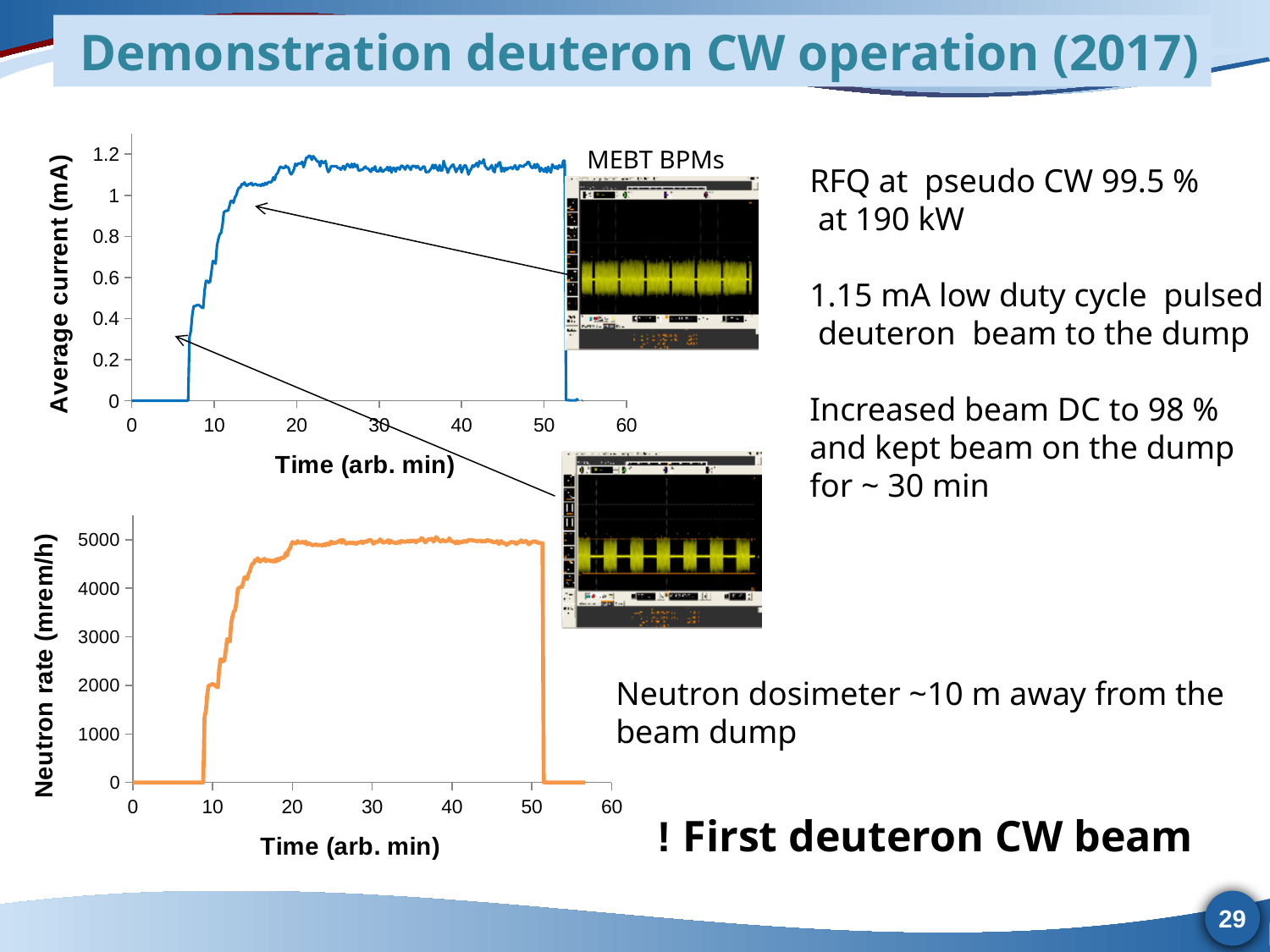
In the top chart, is the average current at time 10 greater or less than 0.4 mA? greater In the bottom chart, does the neutron rate rise or fall between time 10 and time 20? rise In the top chart, is the average current at time 30 greater or less than 1 mA? greater In the top chart, is the average current at time 5 greater or less than 0.2 mA? less What kind of chart is the top chart (Average current vs Time)? line chart What is the x-axis label of the top chart? Time (arb. min) What is the y-axis label of the bottom chart? Neutron rate (mrem/h) In the top chart, does the average current rise or fall between time 10 and time 20? rise What kind of chart is the bottom chart (Neutron rate vs Time)? line chart